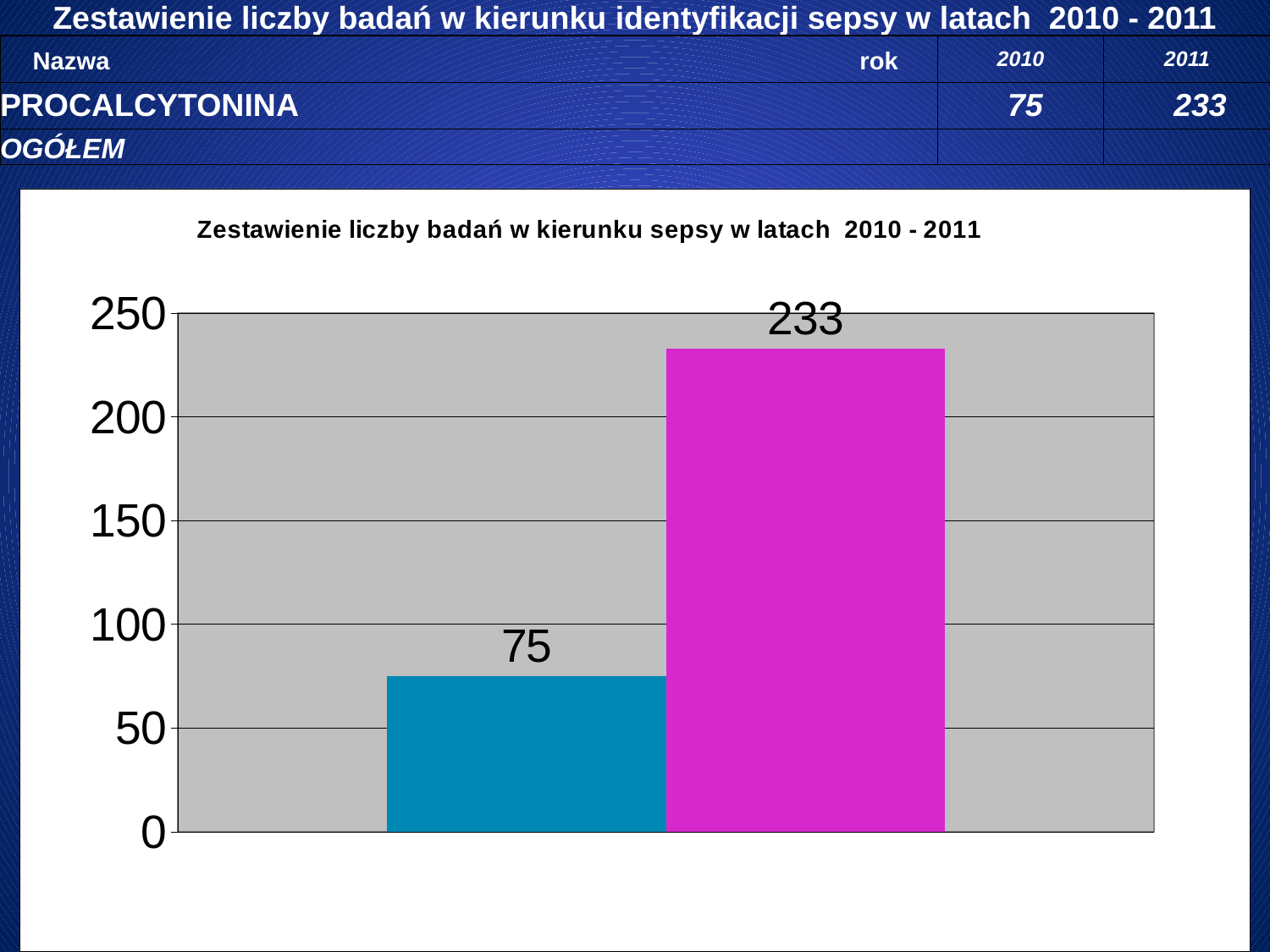
What is the value shown on the left (blue) bar of the chart? 75 According to the table, how many PROCALCYTONINA tests were performed in 2010? 75 Which bar has the lowest value in the chart? the left (blue) bar, 75 What is the value shown on the right (magenta) bar of the chart? 233 What is the title of the chart? Zestawienie liczby badań w kierunku sepsy w latach 2010 - 2011 According to the table, how many PROCALCYTONINA tests were performed in 2011? 233 What is the difference between the two bar values in the chart? 158 Which is larger, the value for 2010 or the value for 2011? 2011 Which bar has the highest value in the chart? the right (magenta) bar, 233 How many bars are plotted in the chart? 2 What type of chart is shown on the slide? bar chart Is the value of the magenta bar greater or less than 200? greater